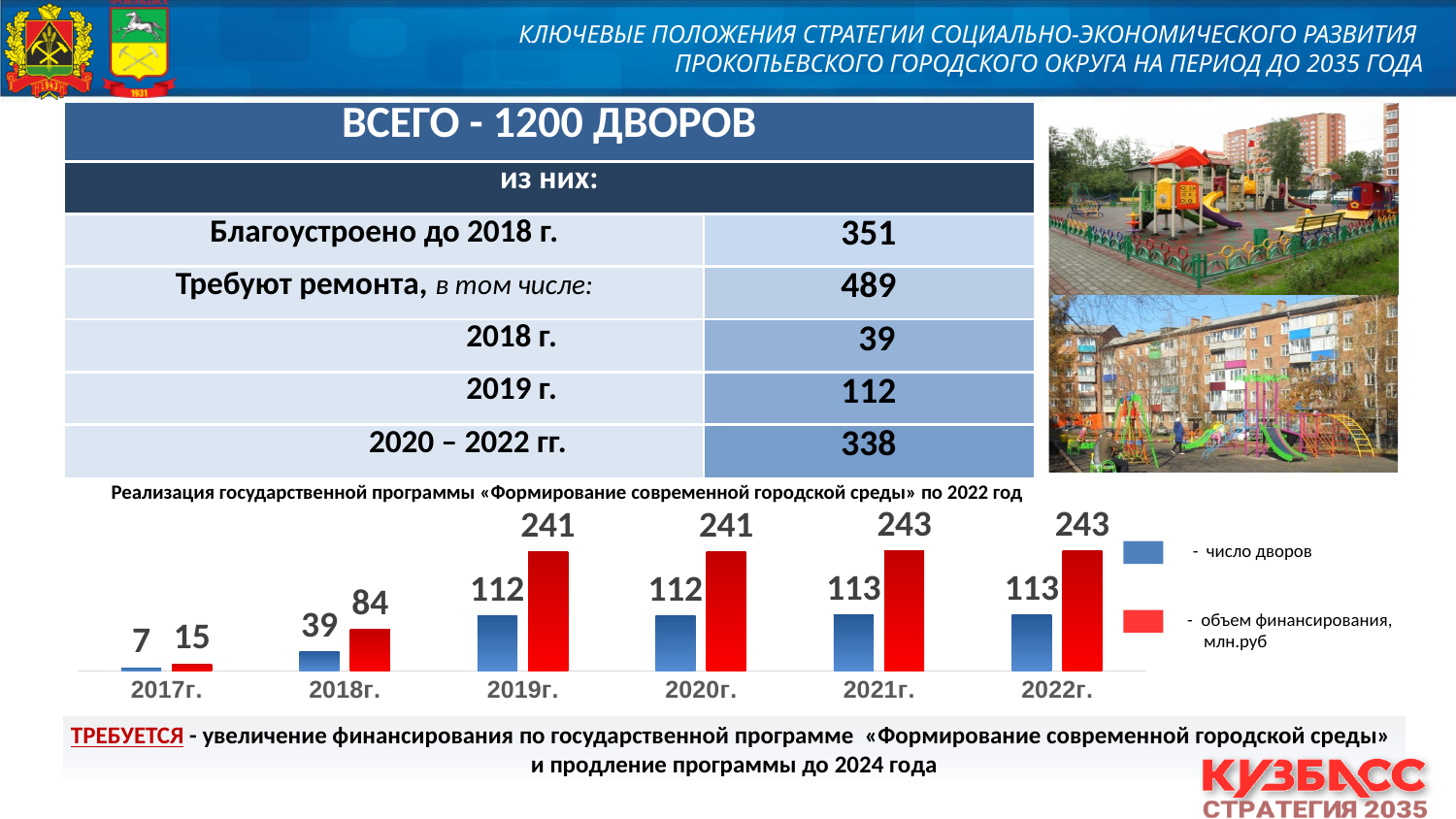
Does the funding volume (объем финансирования) rise or fall from 2017г. to 2022г.? rise Which is larger: the funding volume for 2018г. or the number of courtyards for 2019г.? the number of courtyards for 2019г. What is the funding volume (объем финансирования, млн.руб) shown for 2018г.? 84 How many series does the chart legend list? 2 What is the difference between the number of courtyards in 2018г. and in 2017г.? 32 What kind of chart is shown on the slide? bar chart What is the number of courtyards (число дворов) shown for 2019г.? 112 What is the difference between the funding volume for 2019г. and for 2018г.? 157 Which year has the lowest number of courtyards (число дворов)? 2017г. Which colour represents the funding volume (объем финансирования, млн.руб) in the chart? red How many years are shown on the x axis of the chart? 6 What is the funding volume (объем финансирования, млн.руб) shown for 2022г.? 243